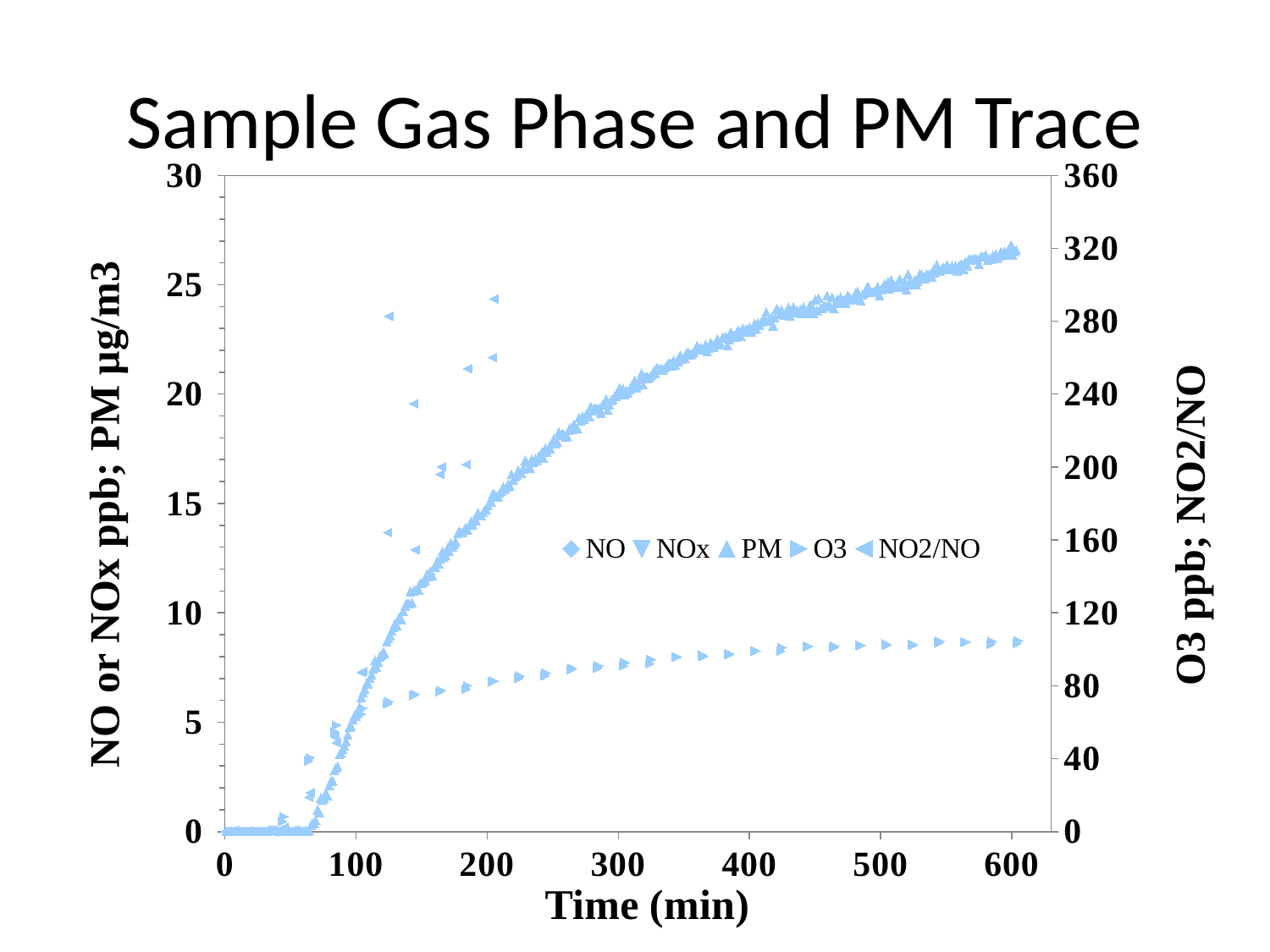
Does the PM series rise or fall as time increases along the x axis? rise What is the label of the x axis? Time (min) Is the O3 value at 600 min greater or less than 80 on the right axis? greater What is the maximum value shown on the right y axis? 360 Is the PM value at 300 min greater or less than 15 on the left axis? greater Is the PM value at 100 min greater or less than 10 on the left axis? less What is the title of the chart? Sample Gas Phase and PM Trace How many series does the legend list? 5 Does the O3 series rise or fall as time increases from 100 to 600 min? rise What kind of chart is shown on the slide? scatter chart